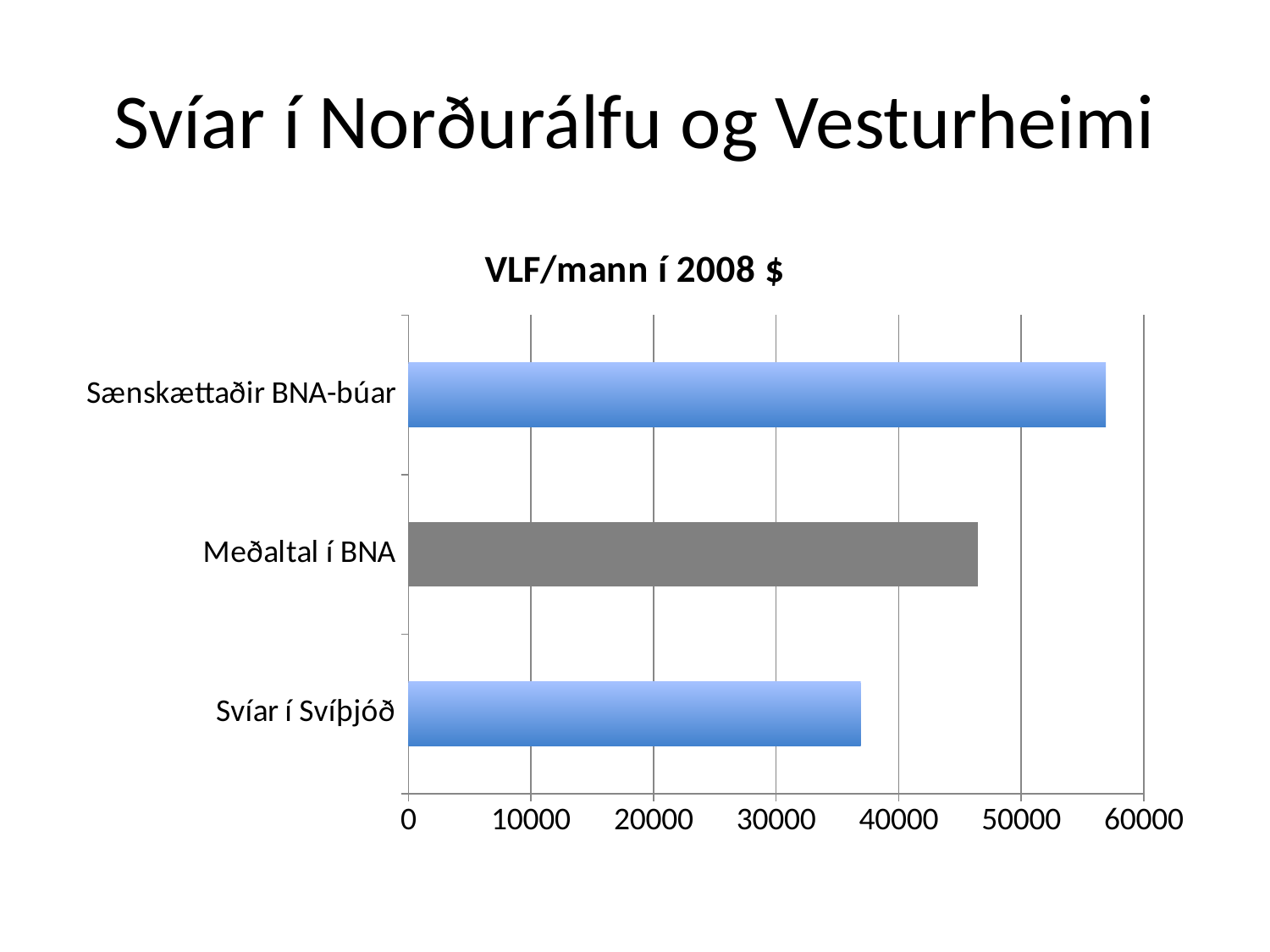
What is the highest value shown on the horizontal axis? 60000 Which is larger, the value for Meðaltal í BNA or the value for Svíar í Svíþjóð? Meðaltal í BNA What kind of chart is shown on the slide? bar chart How many categories are plotted in the chart? 3 Which category has the highest value? Sænskættaðir BNA-búar Which is larger, the value for Sænskættaðir BNA-búar or the value for Meðaltal í BNA? Sænskættaðir BNA-búar Which category has the lowest value? Svíar í Svíþjóð Is the value for Meðaltal í BNA greater or less than 50000? less Is the value for Meðaltal í BNA greater or less than 40000? greater Is the value for Svíar í Svíþjóð greater or less than 40000? less What is the title of the chart? VLF/mann í 2008 $